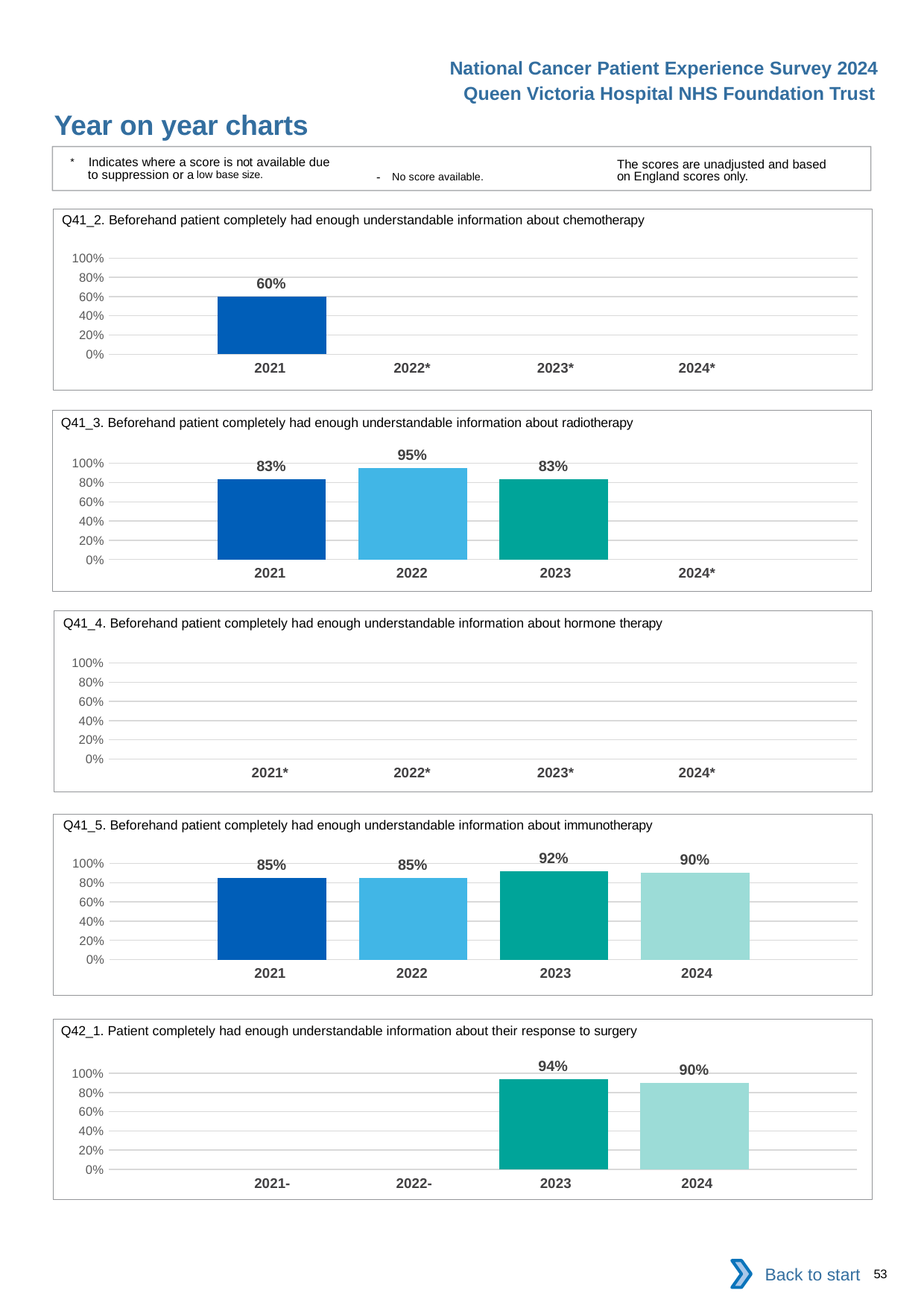
In the Q41_5 chart (immunotherapy), is the value for 2024 greater or less than 2023? less In the Q42_1 chart (response to surgery), what is the value for 2023? 94% In the Q41_2 chart (chemotherapy), is the value for 2021 greater or less than 80%? less In the Q41_2 chart (chemotherapy), what is the value for 2021? 60% In the Q41_3 chart (radiotherapy), which year has the highest value? 2022 In the Q41_5 chart (immunotherapy), which year has the highest value? 2023 In the Q41_5 chart (immunotherapy), what is the value for 2023? 92% In the Q41_3 chart (radiotherapy), what is the difference between the 2022 and 2023 values? 12 percentage points In the Q41_4 chart (hormone therapy), how many bars are plotted? 0 In the Q41_3 chart (radiotherapy), how many years have a plotted bar? 3 In the Q42_1 chart (response to surgery), what is the difference between the 2023 and 2024 values? 4 percentage points What kind of chart is the Q41_5 chart (immunotherapy)? Bar chart